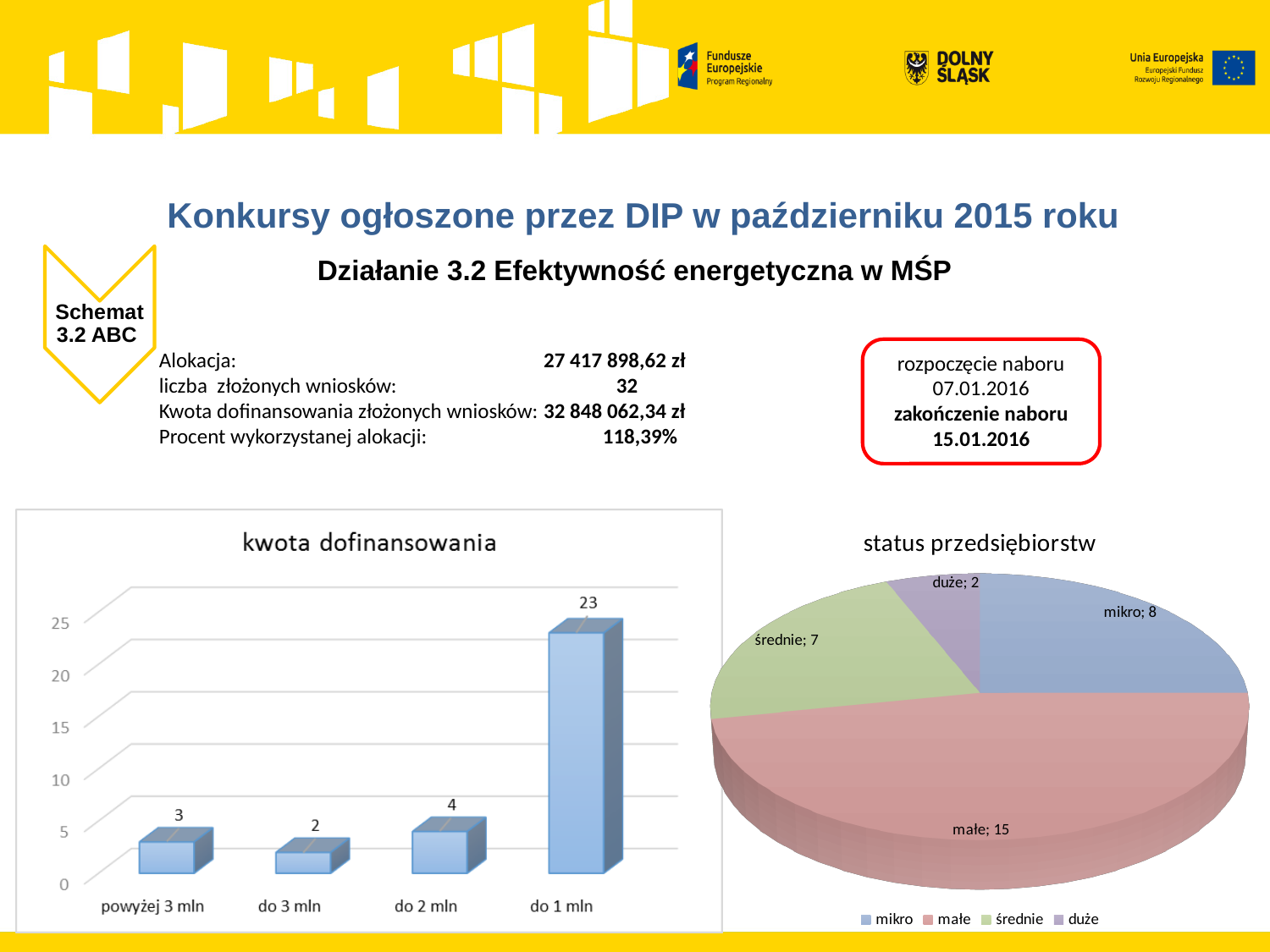
In the 'kwota dofinansowania' chart, how many categories are shown on the x axis? 4 What type of chart is the 'kwota dofinansowania' chart? bar chart In the 'kwota dofinansowania' chart, what is the difference between the values for 'do 1 mln' and 'do 2 mln'? 19 In the 'kwota dofinansowania' chart, which category has the lowest value? do 3 mln In the 'kwota dofinansowania' chart, what is the value for 'do 1 mln'? 23 In the 'kwota dofinansowania' chart, which category has the highest value? do 1 mln In the 'status przedsiębiorstw' chart, what share of the total does 'mikro' represent? 25% In the 'status przedsiębiorstw' chart, which category has the smallest slice? duże In the 'status przedsiębiorstw' chart, which is larger, 'mikro' or 'średnie'? mikro How many entries does the legend of the 'status przedsiębiorstw' chart list? 4 In the 'kwota dofinansowania' chart, what is the value for 'powyżej 3 mln'? 3 In the 'status przedsiębiorstw' chart, what is the value for 'małe'? 15